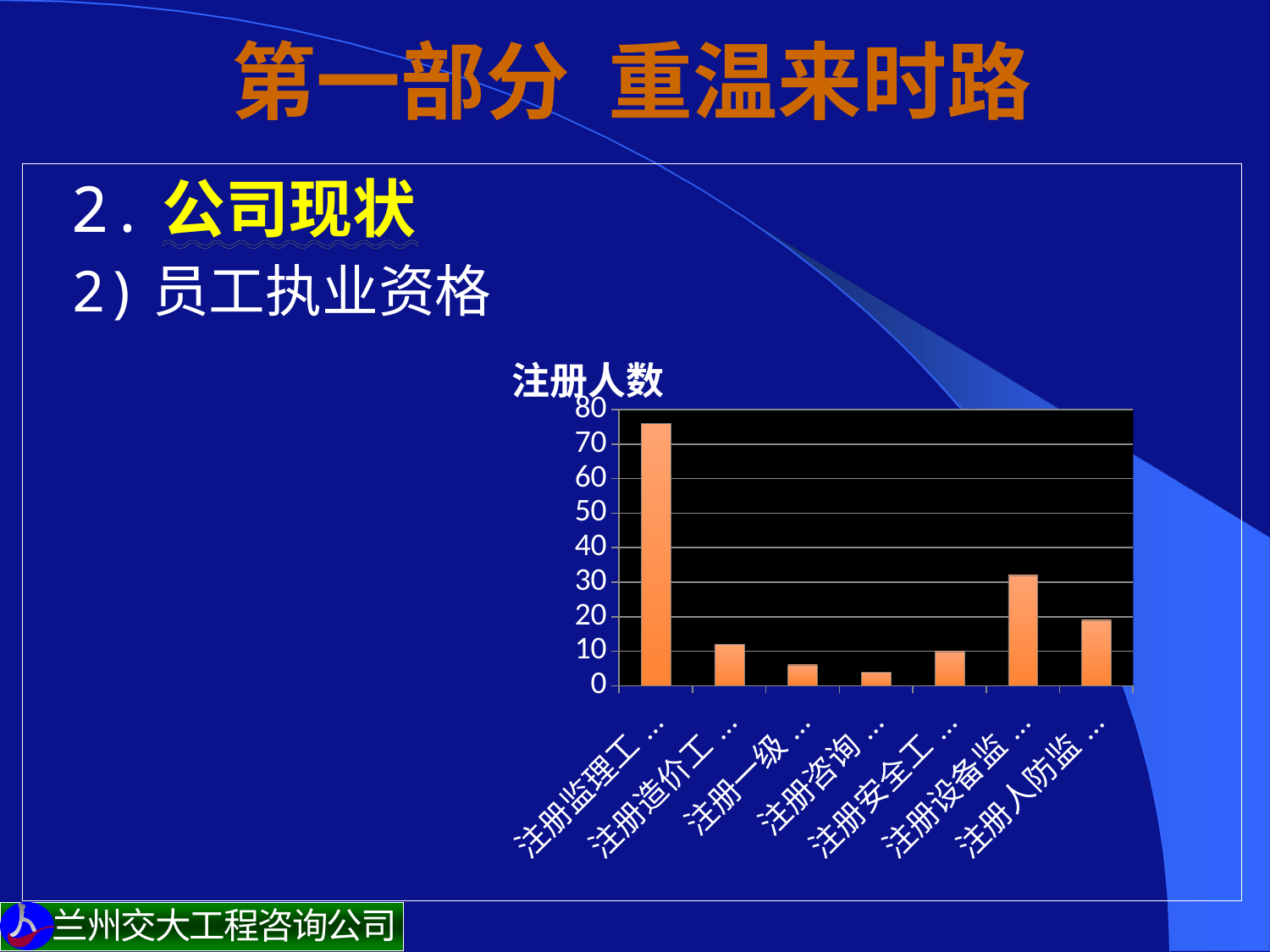
What is the title of the chart? 注册人数 How many categories are plotted in the chart? 7 Is the value for 注册监理工… greater or less than 70? greater Is the value for 注册设备监… greater or less than 20? greater Which category has the highest value in the chart? 注册监理工… Which is larger, the value for 注册设备监… or the value for 注册人防监…? 注册设备监… Is the value for 注册咨询… greater or less than 10? less What colour are the bars in the chart? orange What kind of chart is shown on the slide? bar chart